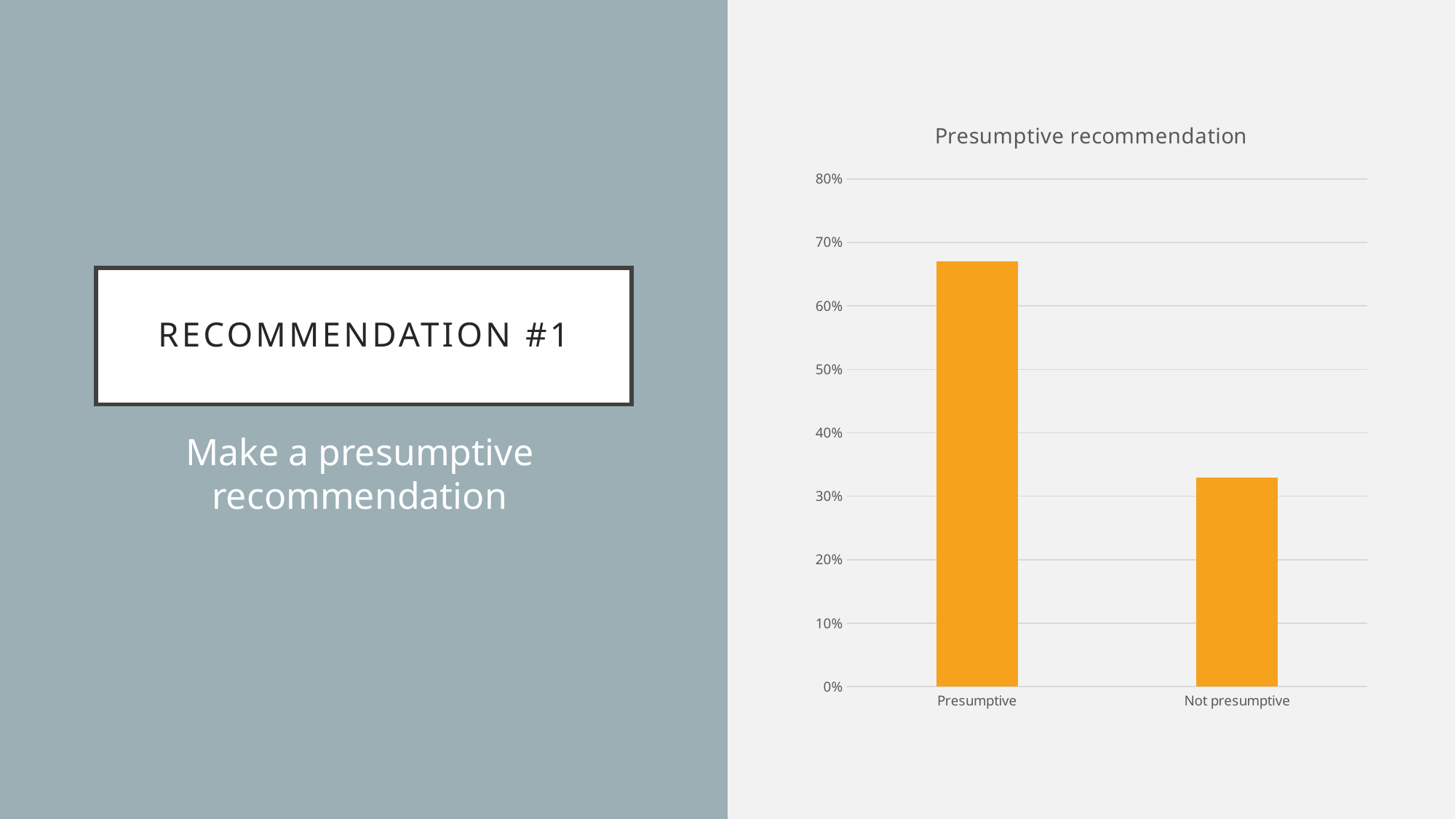
Which category has the lowest value in the chart? Not presumptive How many categories are shown on the x axis of the chart? 2 Is the value for Not presumptive greater or less than 40%? less What kind of chart is shown on the slide? bar chart Is the value for Presumptive greater or less than 60%? greater Which is larger, the value for Presumptive or the value for Not presumptive? Presumptive Do the values rise or fall from Presumptive to Not presumptive along the x axis? fall Is the value for Not presumptive greater or less than 30%? greater What is the highest value shown on the y axis of the chart? 80% Which category has the highest value in the chart? Presumptive What is the title of the chart? Presumptive recommendation